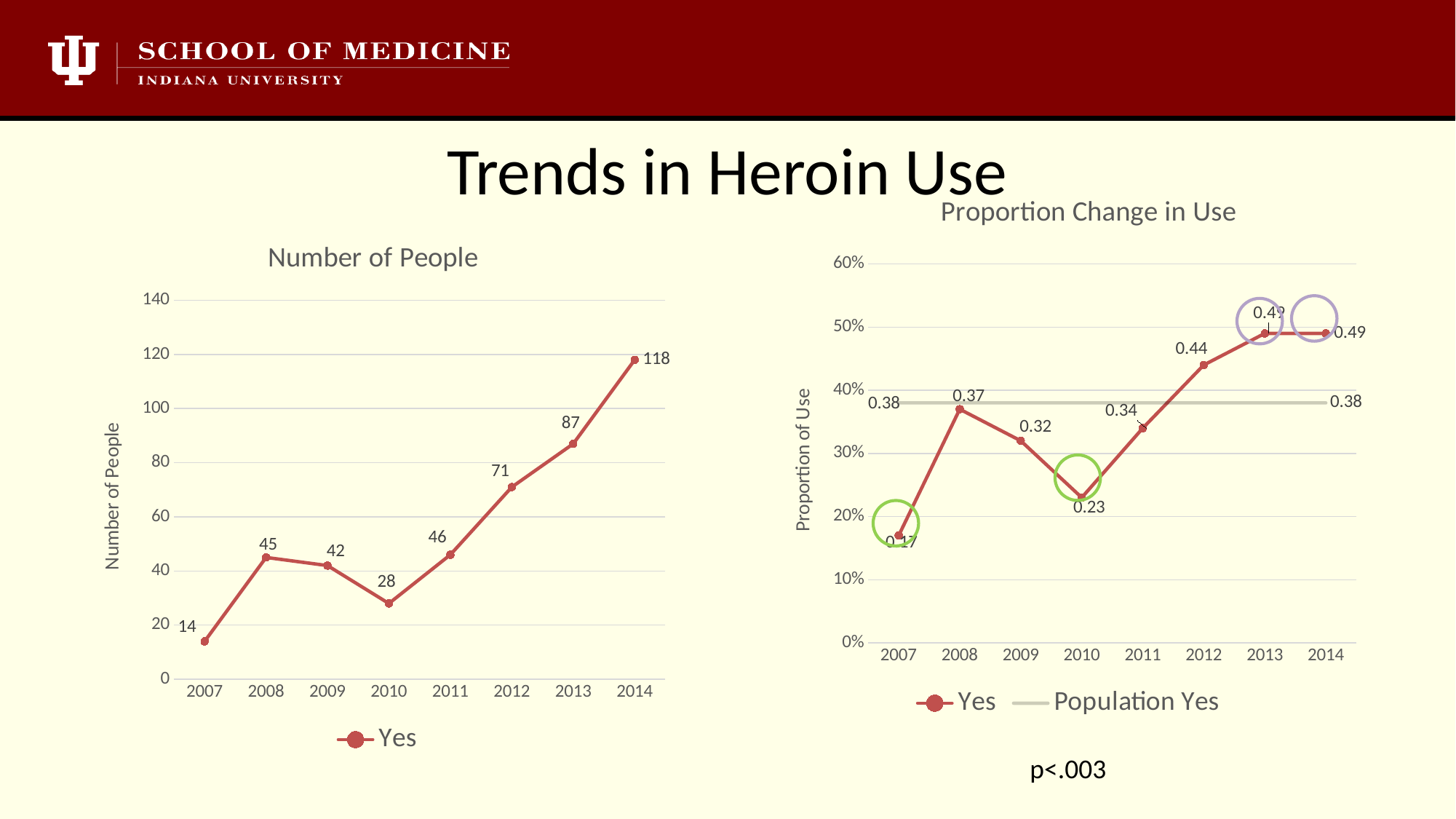
In the "Proportion Change in Use" chart, what is the Yes value for 2012? 0.44 In the "Number of People" chart, how many years are plotted on the x axis? 8 In the "Proportion Change in Use" chart, what is the Yes value for 2010? 0.23 In the "Proportion Change in Use" chart, is the Yes value for 2008 larger or smaller than the Yes value for 2009? Larger How many series does the legend of the "Proportion Change in Use" chart list? 2 In the "Proportion Change in Use" chart, which year has the lowest Yes value? 2007 In the "Number of People" chart, which year has the lowest value? 2007 In the "Number of People" chart, what is the value for 2010? 28 What kind of chart is the "Number of People" chart? Line chart In the "Number of People" chart, what is the value for 2014? 118 In the "Proportion Change in Use" chart, what is the value of the Population Yes line? 0.38 In the "Number of People" chart, what is the difference between the values for 2014 and 2013? 31